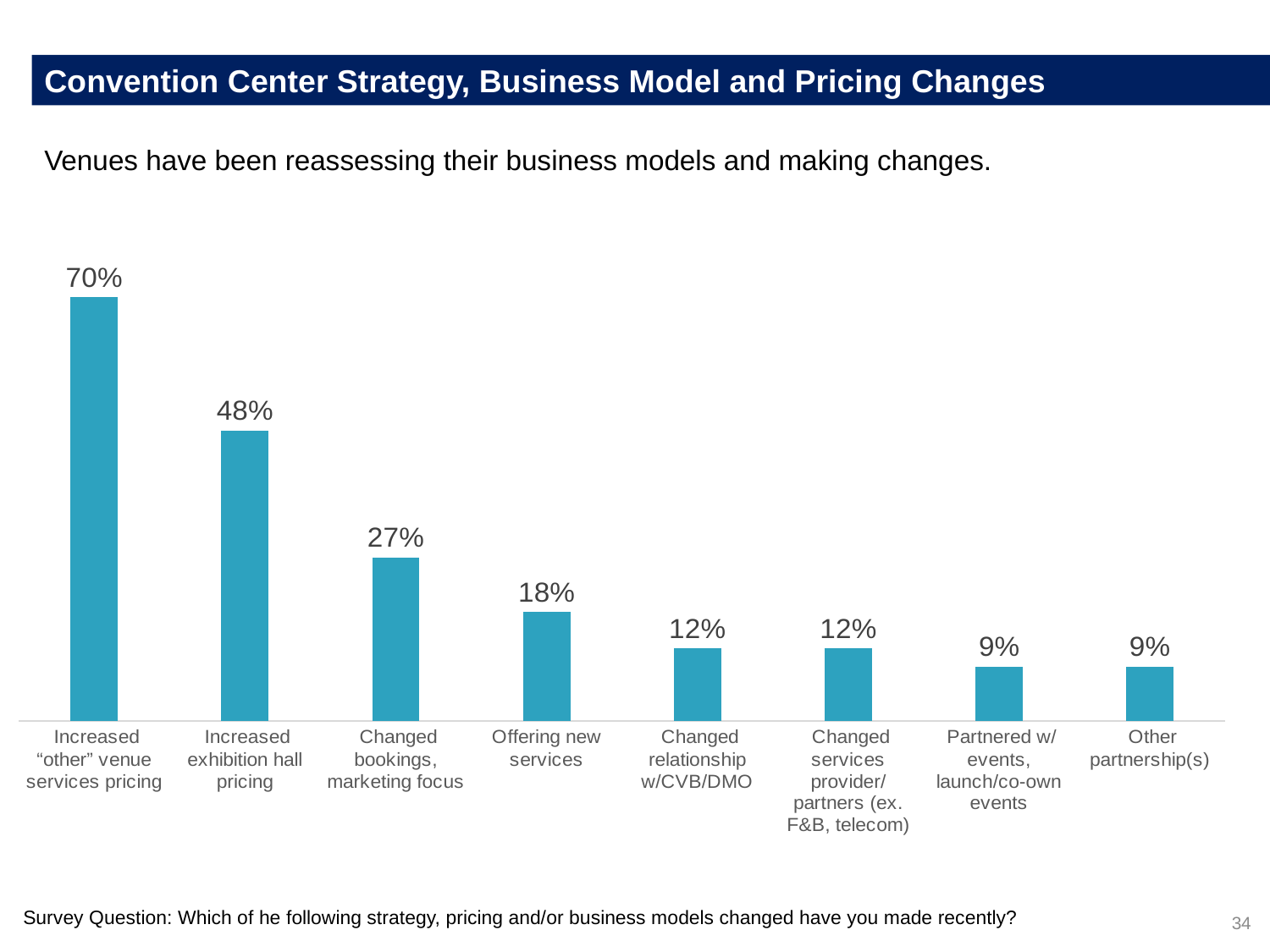
What percentage of venues increased "other" venue services pricing? 70% What is the value for "Offering new services"? 18% What is the value for "Other partnership(s)"? 9% Do the values rise or fall from left to right across the categories? Fall What is the value for "Increased exhibition hall pricing"? 48% What is the difference between "Increased "other" venue services pricing" and "Increased exhibition hall pricing"? 22% Which is larger: "Changed bookings, marketing focus" or "Changed relationship w/CVB/DMO"? Changed bookings, marketing focus What is the value for "Changed relationship w/CVB/DMO"? 12% Which category has the highest value? Increased "other" venue services pricing What kind of chart is shown on the slide? Bar chart What is the difference between "Changed bookings, marketing focus" and "Offering new services"? 9% How many categories are shown in the chart? 8